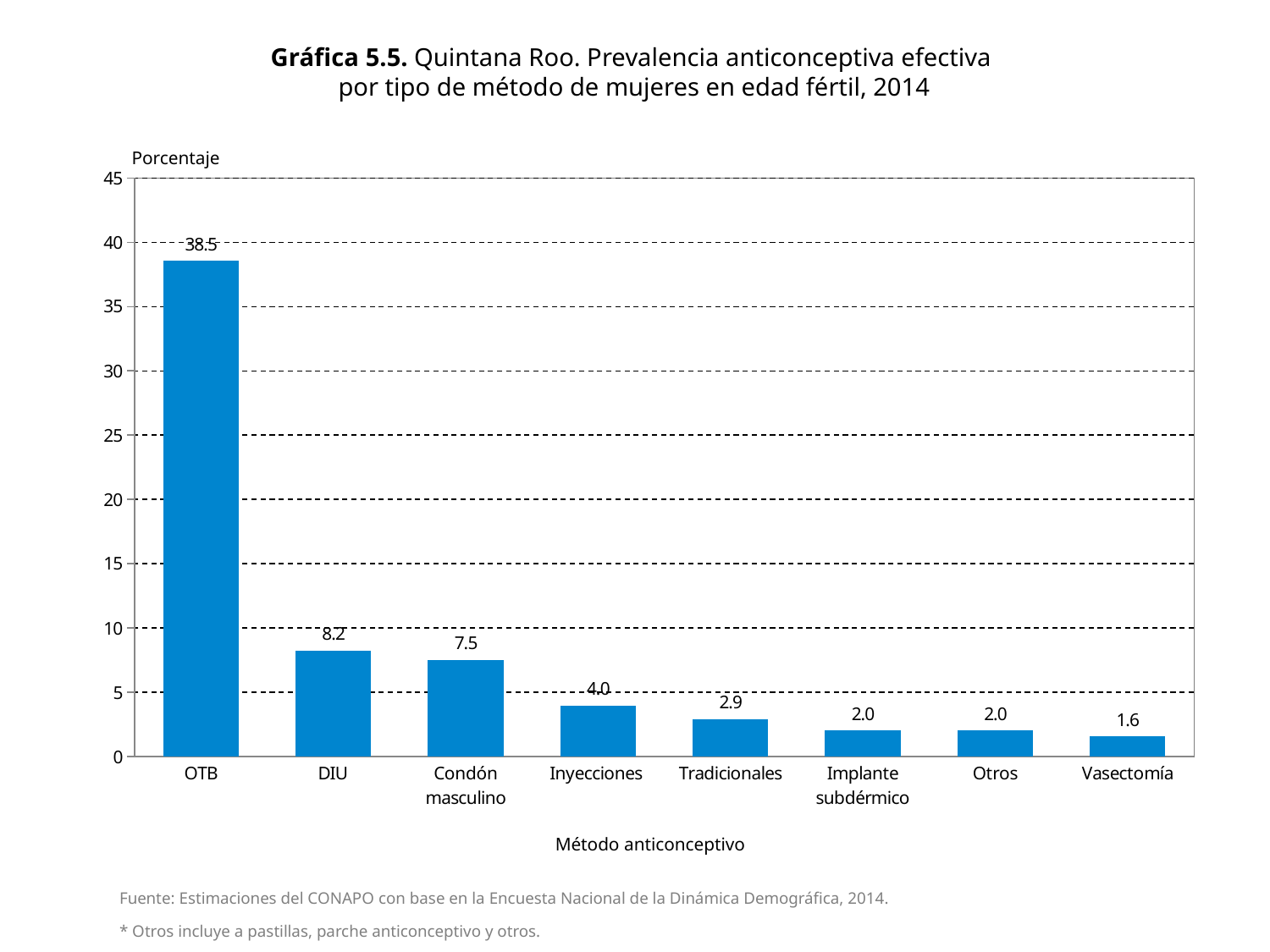
Is the value for OTB greater or less than 35? greater What is the value for Vasectomía? 1.6 What is the label of the y axis? Porcentaje What is the value for OTB? 38.5 Which contraceptive method has the highest value? OTB Which contraceptive method has the lowest value? Vasectomía Which is larger, the value for Tradicionales or the value for Implante subdérmico? Tradicionales Do the values rise or fall from left to right along the x axis? fall What is the difference between the values for DIU and Inyecciones? 4.2 What is the value for Condón masculino? 7.5 What kind of chart is this? bar chart How many contraceptive methods are shown on the x axis? 8